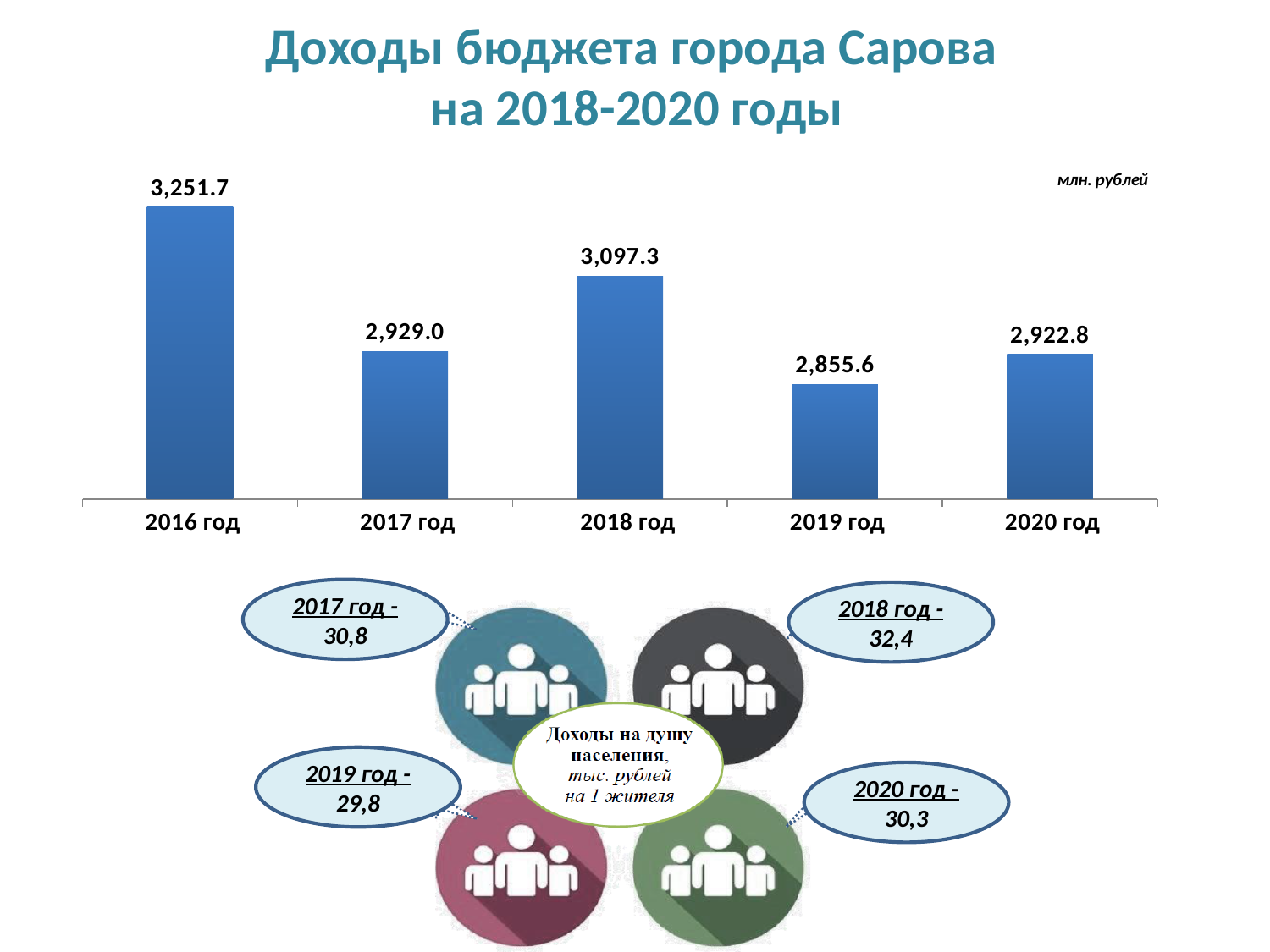
Which year has the lowest budget income in the bar chart? 2019 год What is the budget income value shown for 2016 год? 3,251.7 What unit of measurement is indicated for the bar chart values? млн. рублей Does the budget income rise or fall from 2016 год to 2017 год? Fall Which year has the highest budget income in the bar chart? 2016 год Which is larger, the budget income for 2018 год or for 2017 год? 2018 год What is the difference between the budget income for 2018 год and 2019 год? 241.7 What type of chart is used to show the budget income by year? Bar chart How many years (bars) are shown in the bar chart? 5 What is the budget income value shown for 2019 год? 2,855.6 What is the budget income value shown for 2020 год? 2,922.8 What is the difference between the budget income for 2016 год and 2018 год? 154.4